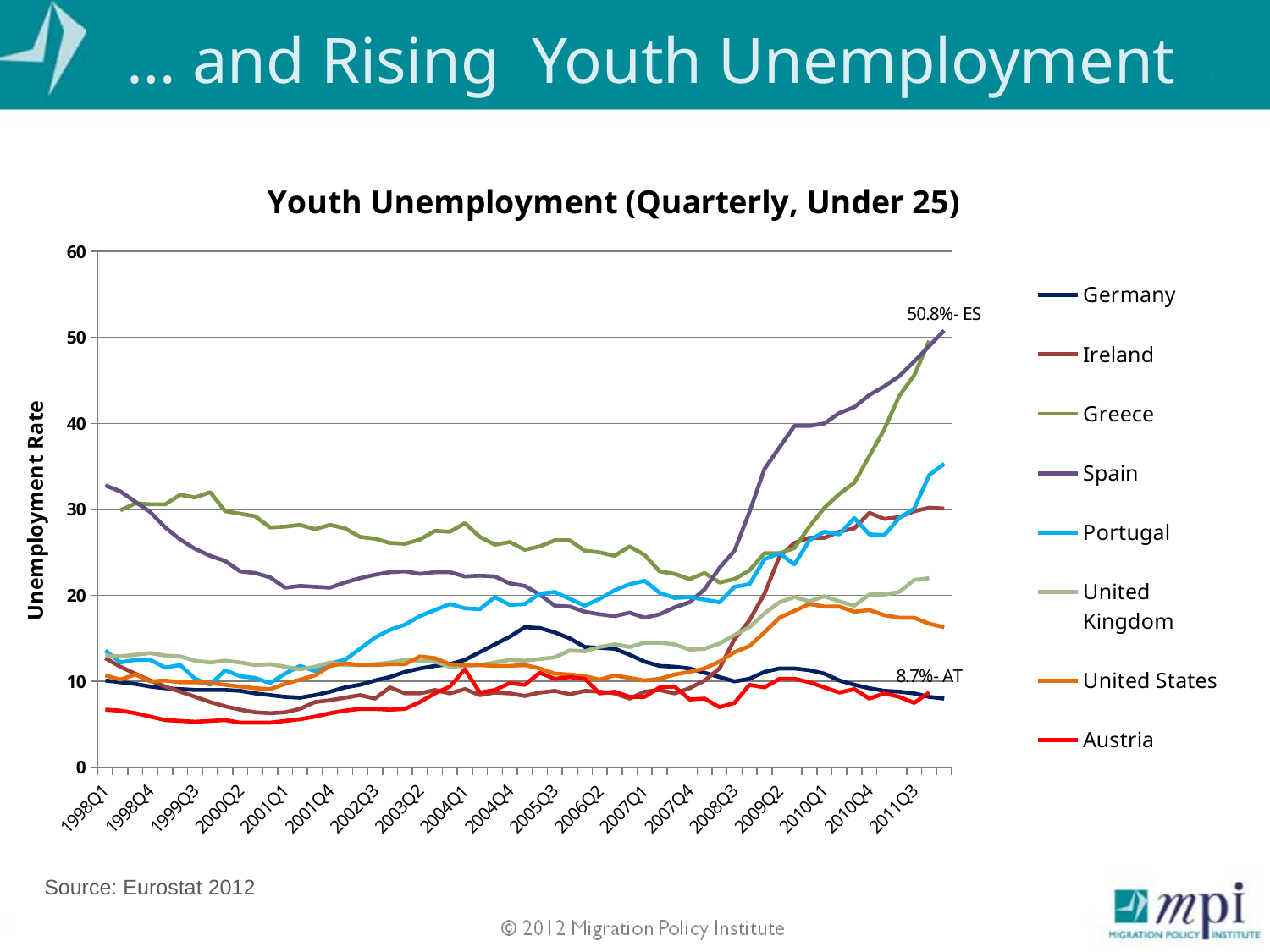
At the end of the series, is the value for Greece greater or less than 40? greater At the end of the series, is the value for the United States greater or less than 20? less What kind of chart is shown on the slide? line chart What is the title of the chart? Youth Unemployment (Quarterly, Under 25) What is the label on the vertical axis of the chart? Unemployment Rate Which country has the highest youth unemployment rate at the end of the series (2011)? Spain What is the labelled final value for Austria (AT) on the chart? 8.7% At the end of the series, which is larger: the value for Greece or the value for the United Kingdom? Greece Does the youth unemployment rate for Spain rise or fall between 2008Q3 and 2011Q3? rise How many series does the legend list? 8 What is the labelled final value for Spain (ES) on the chart? 50.8% What is the difference between the labelled final values for Spain and Austria? 42.1 percentage points